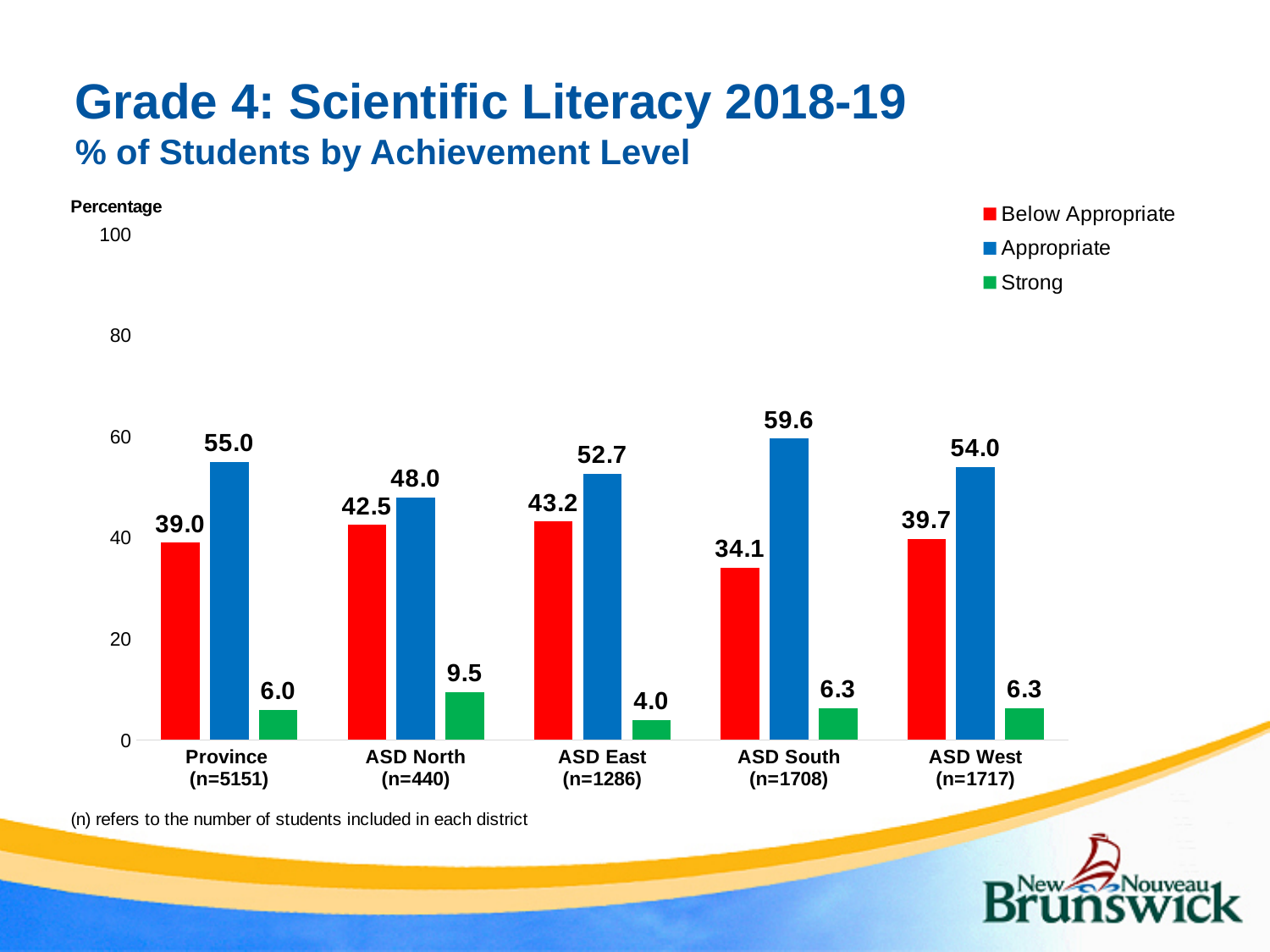
What is the Appropriate percentage for ASD South? 59.6 How many districts (categories) are shown on the x axis? 5 Which is larger, the Below Appropriate percentage for ASD North or for ASD West? ASD North How many series does the legend list? 3 Which district has the lowest Below Appropriate percentage? ASD South What is the Below Appropriate percentage for ASD East? 43.2 What kind of chart is shown on the slide? Bar chart What colour represents the Strong achievement level in the legend? Green Which district has the highest Appropriate percentage? ASD South What is the difference between the Appropriate and Below Appropriate percentages for the Province? 16.0 Which district has the lowest Strong percentage? ASD East What is the Strong percentage for ASD North? 9.5